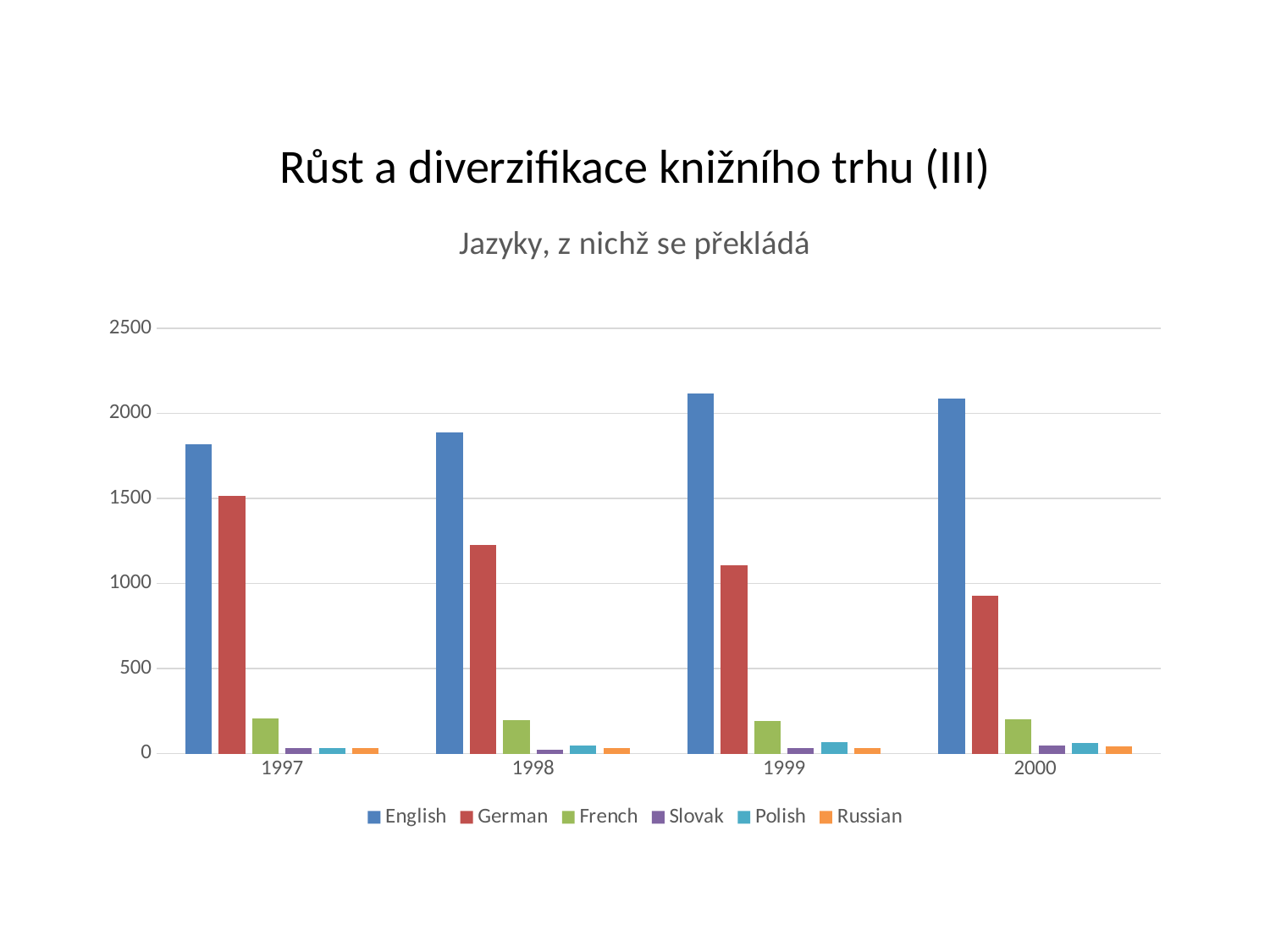
Is the value for German in 1998 greater or less than 1000? greater In which year is the German bar the highest? 1997 What is the title of the chart? Jazyky, z nichž se překládá How many series does the legend list? 6 Is the value for English in 1999 greater or less than 2000? greater Is the value for German in 2000 greater or less than 1000? less Which is larger in 2000, the English bar or the German bar? English Do the German values rise or fall from 1997 to 2000? fall How many years are shown on the x axis? 4 Which language has the highest bar in 1997? English What kind of chart is shown on the slide? bar chart